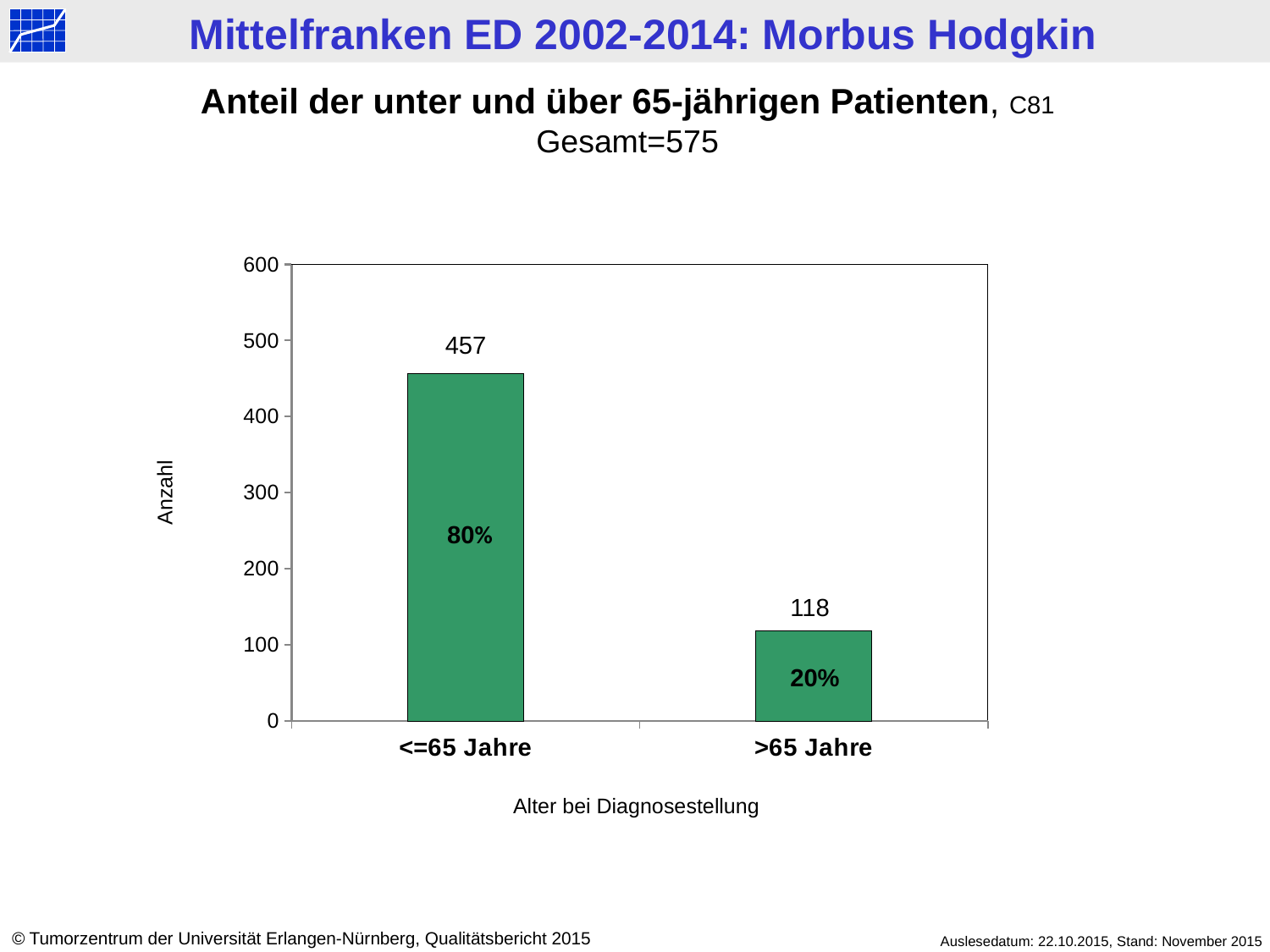
What is the difference between the values for <=65 Jahre and >65 Jahre? 339 How many categories are shown on the x axis? 2 What is the value for the <=65 Jahre category? 457 What percentage is shown on the >65 Jahre bar? 20% What percentage is shown on the <=65 Jahre bar? 80% Which is larger, the value for <=65 Jahre or for >65 Jahre? <=65 Jahre Which category has the lowest value? >65 Jahre Is the value for >65 Jahre greater or less than 200? less Which category has the highest value? <=65 Jahre What is the label of the y axis? Anzahl What is the value for the >65 Jahre category? 118 What kind of chart is shown on the slide? bar chart